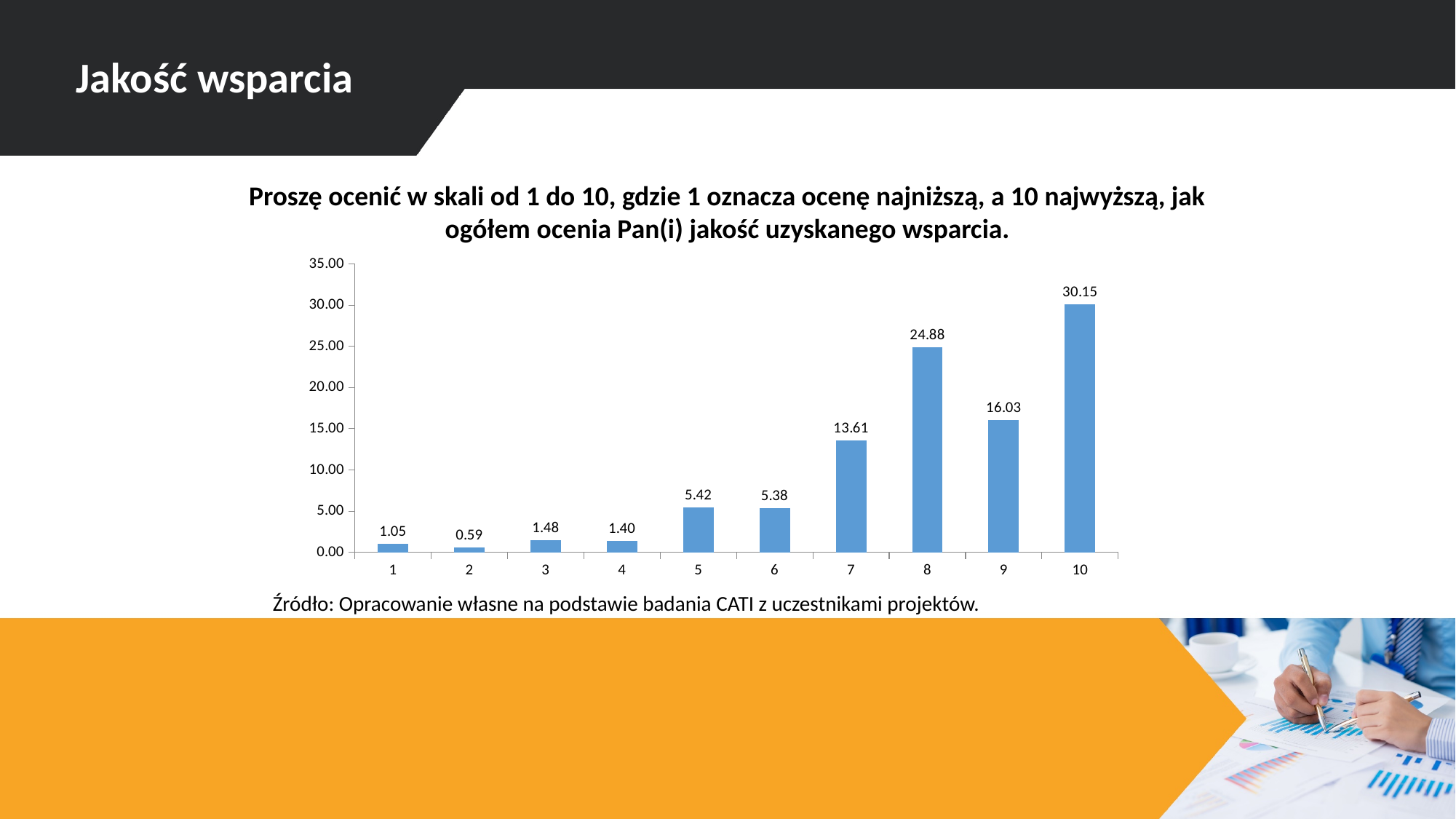
What is the value for rating 7? 13.61 What kind of chart is shown on the slide? bar chart What is the difference between the values for rating 10 and rating 8? 5.27 Do the values generally rise or fall from rating 6 to rating 8? rise What is the value for rating 10? 30.15 Which rating has the highest value? 10 Is the value for rating 9 greater or less than 15.00? greater Which rating has the lowest value? 2 Which is larger, the value for rating 5 or rating 6? 5 How many rating categories are shown on the x axis? 10 What is the highest tick value shown on the y axis? 35.00 What is the value for rating 2? 0.59